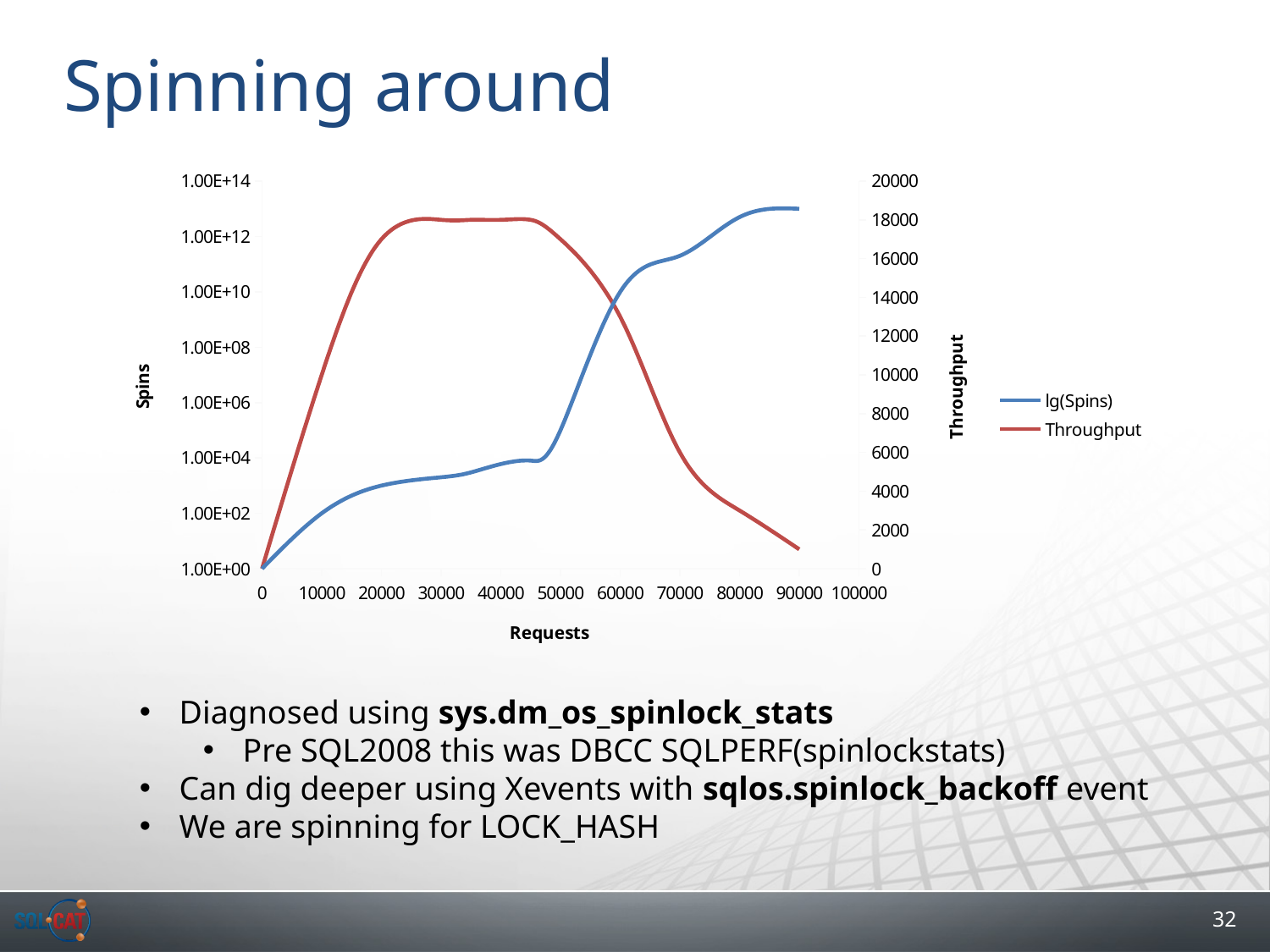
Which series rises to a plateau and then declines as Requests increase? Throughput What is the title of the chart's x axis? Requests Is the Throughput value at 70000 Requests greater or less than 8000? less Does the Throughput line rise or fall as Requests increase from 40000 to 90000? fall What kind of chart is shown on the slide? Line chart Is the Throughput value at 30000 Requests greater or less than 16000? greater Does the lg(Spins) line rise or fall overall as Requests increase from 0 to 90000? rise Is the Throughput value at 90000 Requests greater or less than 2000? less How many series does the chart's legend list? 2 What are the two series named in the chart's legend? lg(Spins) and Throughput